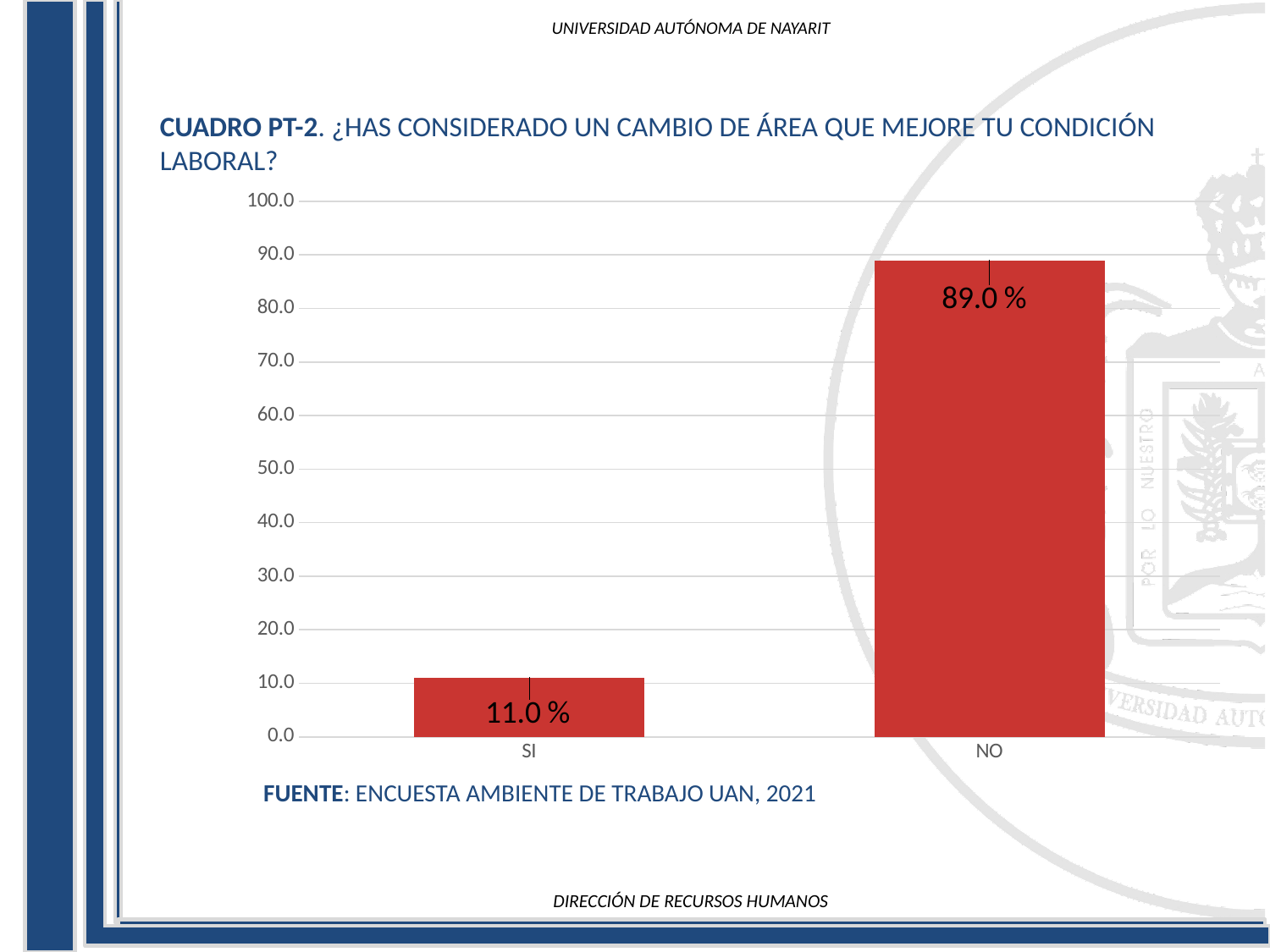
What kind of chart is shown on the slide? bar chart Which category has the highest value? NO Which is larger, the value for SI or the value for NO? NO Is the value for NO greater or less than 80.0? greater Which category has the lowest value? SI What is the value for NO? 89.0 % What is the difference between the values for NO and SI? 78.0 % What is the source cited below the chart? ENCUESTA AMBIENTE DE TRABAJO UAN, 2021 What is the highest value shown on the y axis? 100.0 What is the value for SI? 11.0 % Is the value for SI greater or less than 20.0? less How many categories are shown on the x axis? 2